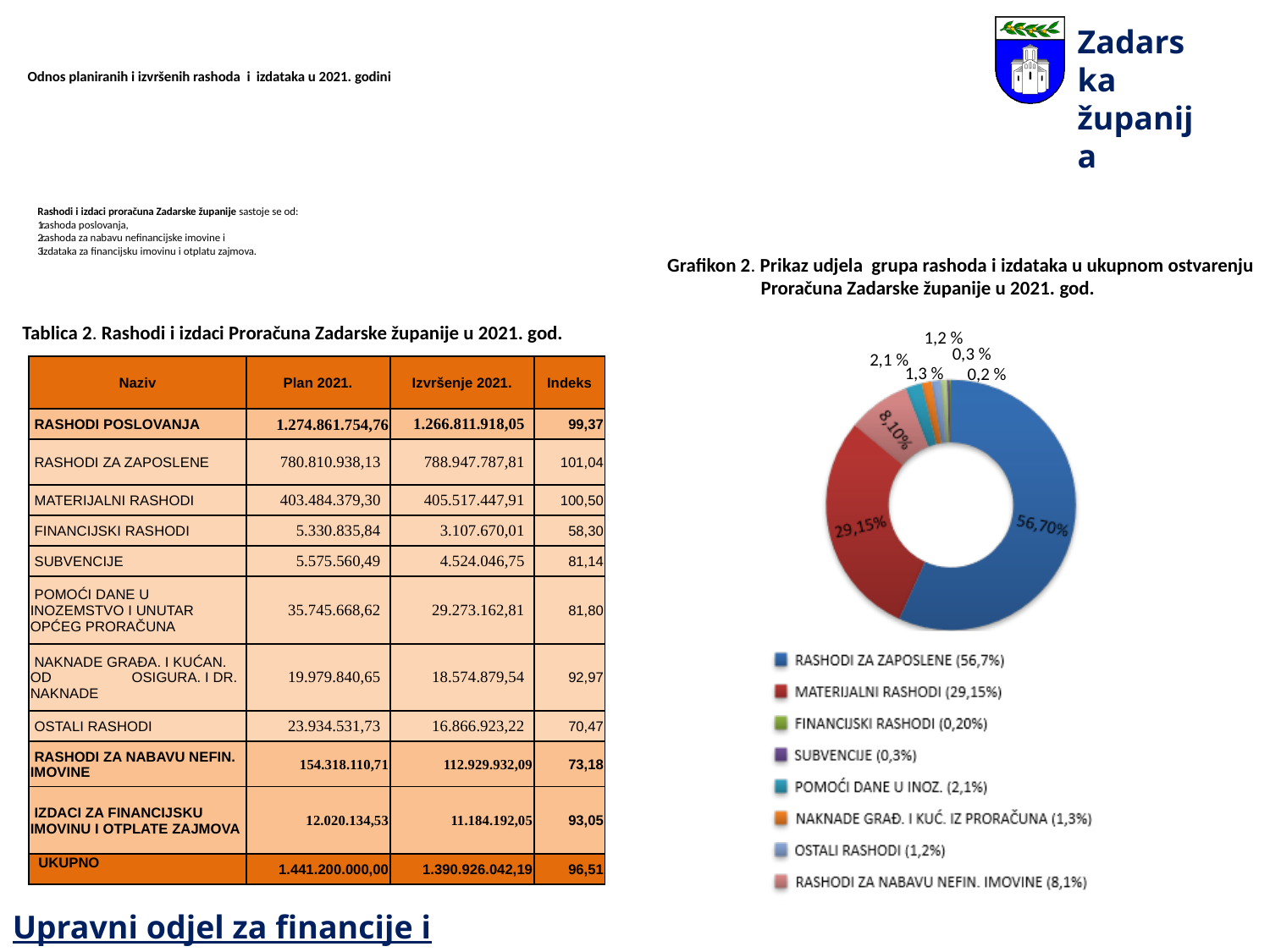
How many categories does the legend of Grafikon 2 list? 8 In Grafikon 2, which has the larger share: NAKNADE GRAĐ. I KUĆ. IZ PRORAČUNA or OSTALI RASHODI? NAKNADE GRAĐ. I KUĆ. IZ PRORAČUNA What kind of chart is Grafikon 2 on the slide? doughnut chart In Grafikon 2, which category has the largest share? RASHODI ZA ZAPOSLENE In Grafikon 2, what share does MATERIJALNI RASHODI have? 29,15% What is the share of SUBVENCIJE shown in the legend of Grafikon 2? 0,3% In Grafikon 2, which category has the smallest share? FINANCIJSKI RASHODI In Grafikon 2, what share does RASHODI ZA NABAVU NEFIN. IMOVINE have according to the legend? 8,1% In Grafikon 2, what colour is the slice for RASHODI ZA ZAPOSLENE? blue In Grafikon 2, what is the difference in percentage points between the shares of RASHODI ZA ZAPOSLENE (56,7%) and MATERIJALNI RASHODI (29,15%)? 27,55 percentage points In Grafikon 2, which has the larger share: SUBVENCIJE or POMOĆI DANE U INOZ.? POMOĆI DANE U INOZ.